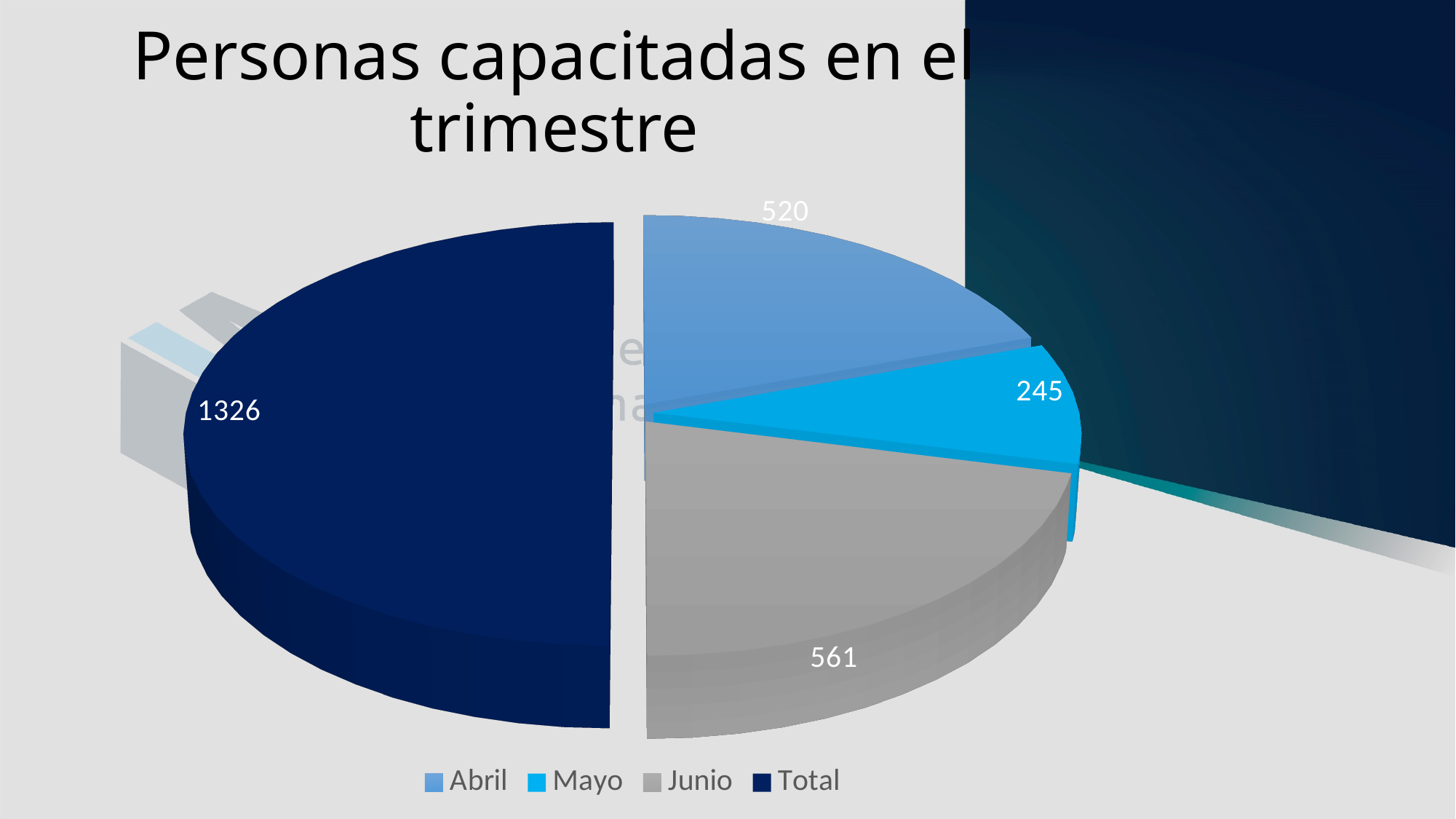
What is the value for Junio? 561 What share of the whole pie does the Total slice represent? 50% What is the title of the chart? Personas capacitadas en el trimestre What kind of chart is shown on the slide? pie chart Which is larger, the value for Junio or the value for Abril? Junio Which slice has the largest value? Total What is the difference between the values for Abril and Mayo? 275 What is the value for Total? 1326 Which slice has the smallest value? Mayo How many entries does the legend list? 4 What is the value for Abril? 520 What is the value for Mayo? 245